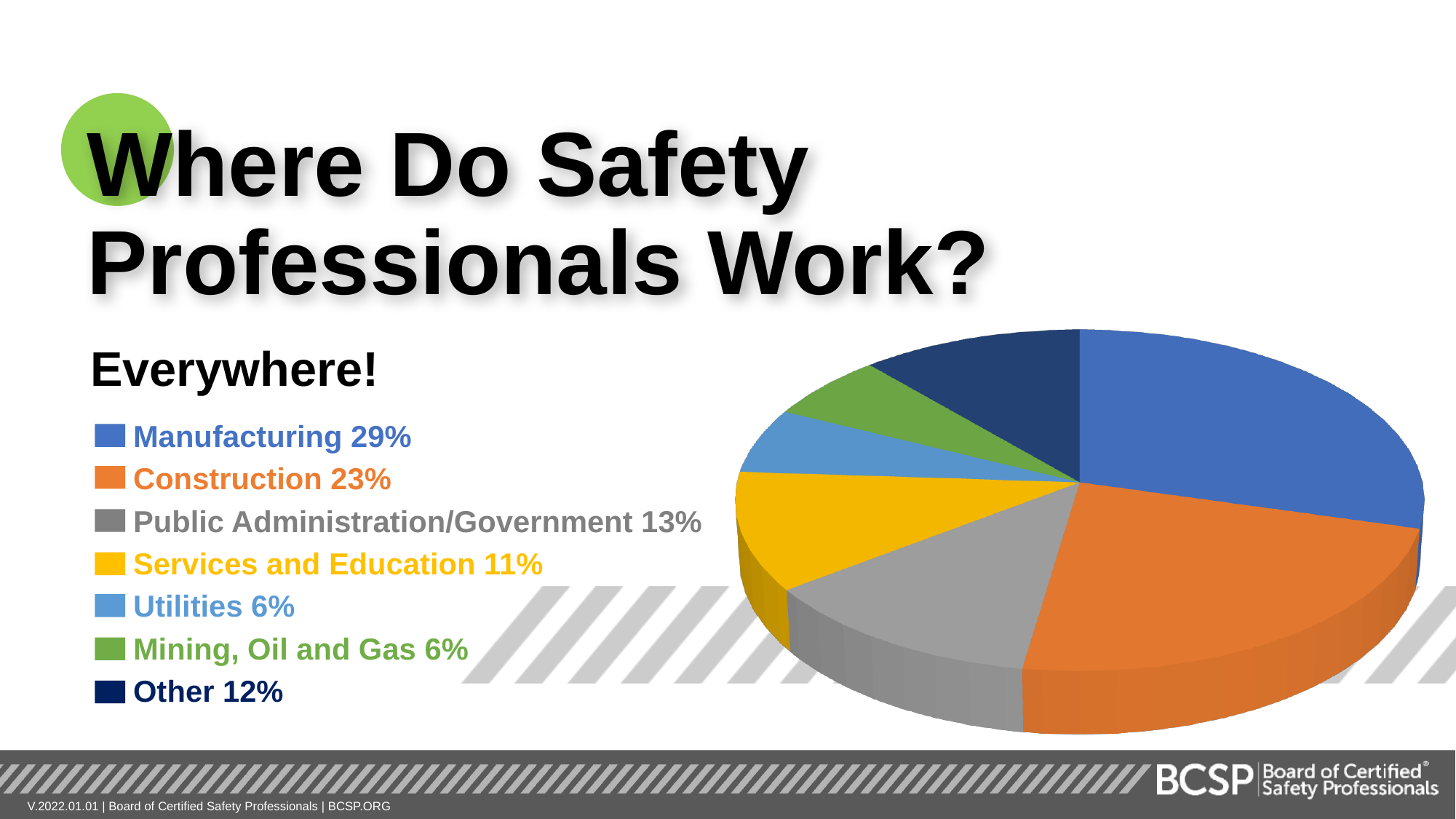
What share of safety professionals work in Public Administration/Government? 13% How many categories does the legend list? 7 What share of safety professionals work in Construction? 23% What share of safety professionals work in Utilities? 6% What share of safety professionals work in Services and Education? 11% What colour represents Mining, Oil and Gas in the chart? Green Which sector has the largest share of safety professionals? Manufacturing What is the difference in percentage points between Manufacturing and Construction? 6 What kind of chart is shown on the slide? Pie chart What share of safety professionals work in Manufacturing? 29% What share is labelled Other? 12% Which is larger, the share for Public Administration/Government or the share for Services and Education? Public Administration/Government